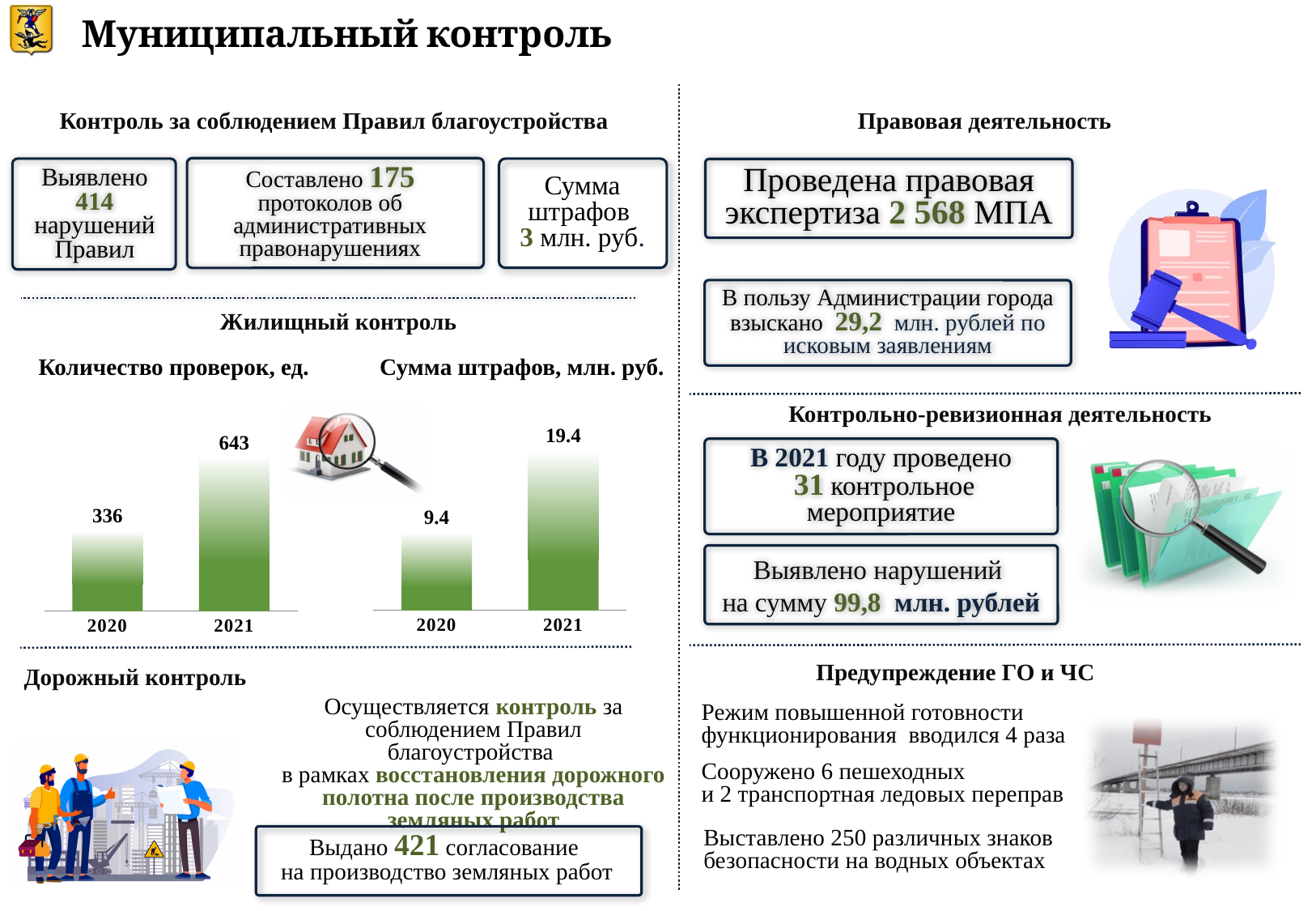
In the chart titled "Сумма штрафов, млн. руб.", which year has the lower value? 2020 In the chart titled "Количество проверок, ед.", which year has the higher value? 2021 In the chart titled "Количество проверок, ед.", what is the value for 2021? 643 In the chart titled "Сумма штрафов, млн. руб.", what is the value for 2021? 19.4 How many categories (years) are shown in the chart titled "Количество проверок, ед."? 2 What type of chart is the chart titled "Сумма штрафов, млн. руб."? bar chart In the chart titled "Количество проверок, ед.", what is the difference between the 2021 and 2020 values? 307 In the chart titled "Сумма штрафов, млн. руб.", is the value for 2021 larger or smaller than the value for 2020? larger In the chart titled "Количество проверок, ед.", do the values rise or fall from 2020 to 2021? rise In the chart titled "Сумма штрафов, млн. руб.", what is the difference between the 2021 and 2020 values? 10 In the chart titled "Количество проверок, ед.", what is the value for 2020? 336 In the chart titled "Сумма штрафов, млн. руб.", what is the value for 2020? 9.4